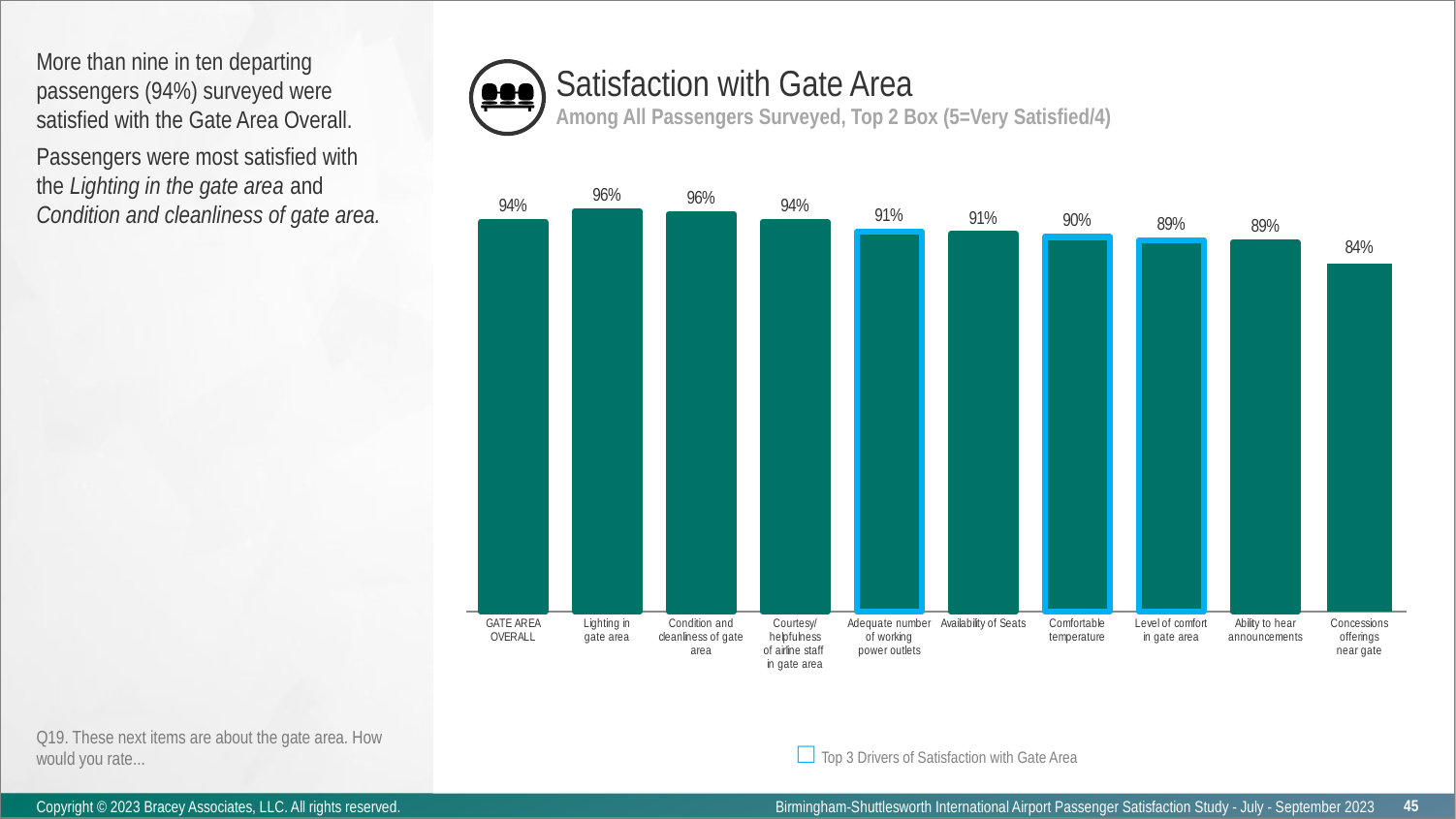
What is the difference between the value for GATE AREA OVERALL and the value for Comfortable temperature? 4% What is the value shown for Lighting in gate area? 96% What is the difference between the value for Lighting in gate area and the value for Concessions offerings near gate? 12% What kind of chart is shown on the slide? Bar chart How many bars are outlined in blue as Top 3 Drivers of Satisfaction with Gate Area? 3 What is the satisfaction value for GATE AREA OVERALL? 94% What is the value shown for Availability of Seats? 91% What is the value shown for Comfortable temperature? 90% Which is larger, the value for Condition and cleanliness of gate area or the value for Ability to hear announcements? Condition and cleanliness of gate area Which category has the lowest satisfaction value? Concessions offerings near gate How many categories are shown in the chart? 10 What is the value shown for Concessions offerings near gate? 84%